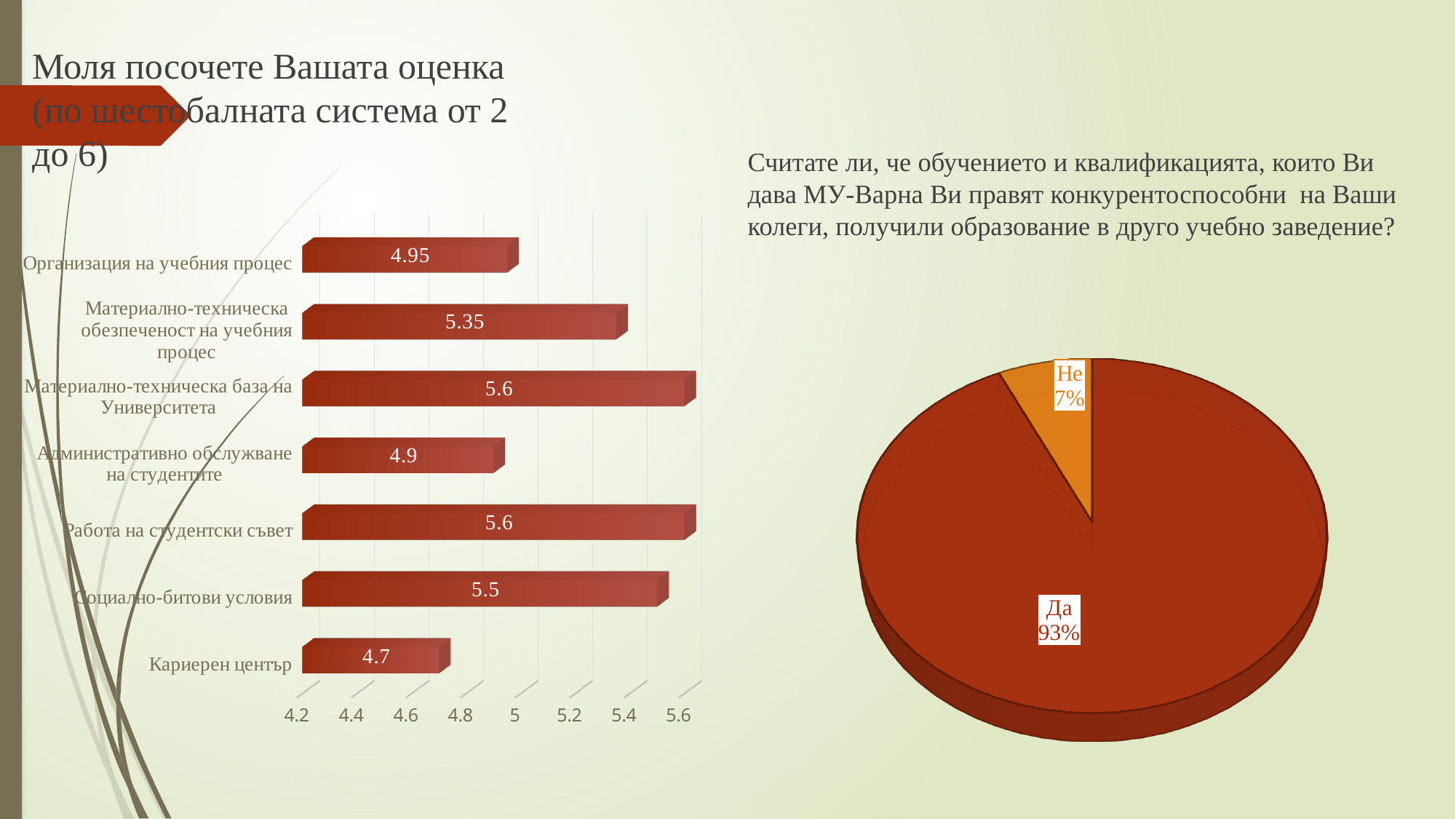
On the left bar chart, what is the difference between the values for Материално-техническа база на Университета and Кариерен център? 0.9 How many categories does the left bar chart show? 7 What kind of chart is on the left side of the slide? bar chart On the right pie chart, what share of responses is Не? 7% On the left bar chart, what is the value for Материално-техническа обезпеченост на учебния процес? 5.35 On the left bar chart, is the value for Работа на студентски съвет greater or less than 5? greater On the right pie chart, what share of responses is Да? 93% On the left bar chart, what is the value for Организация на учебния процес? 4.95 On the left bar chart, what is the value for Кариерен център? 4.7 On the left bar chart, which is larger: the value for Социално-битови условия or the value for Административно обслужване на студентите? Социално-битови условия On the left bar chart, what is the value for Социално-битови условия? 5.5 On the left bar chart, which category has the lowest value? Кариерен център